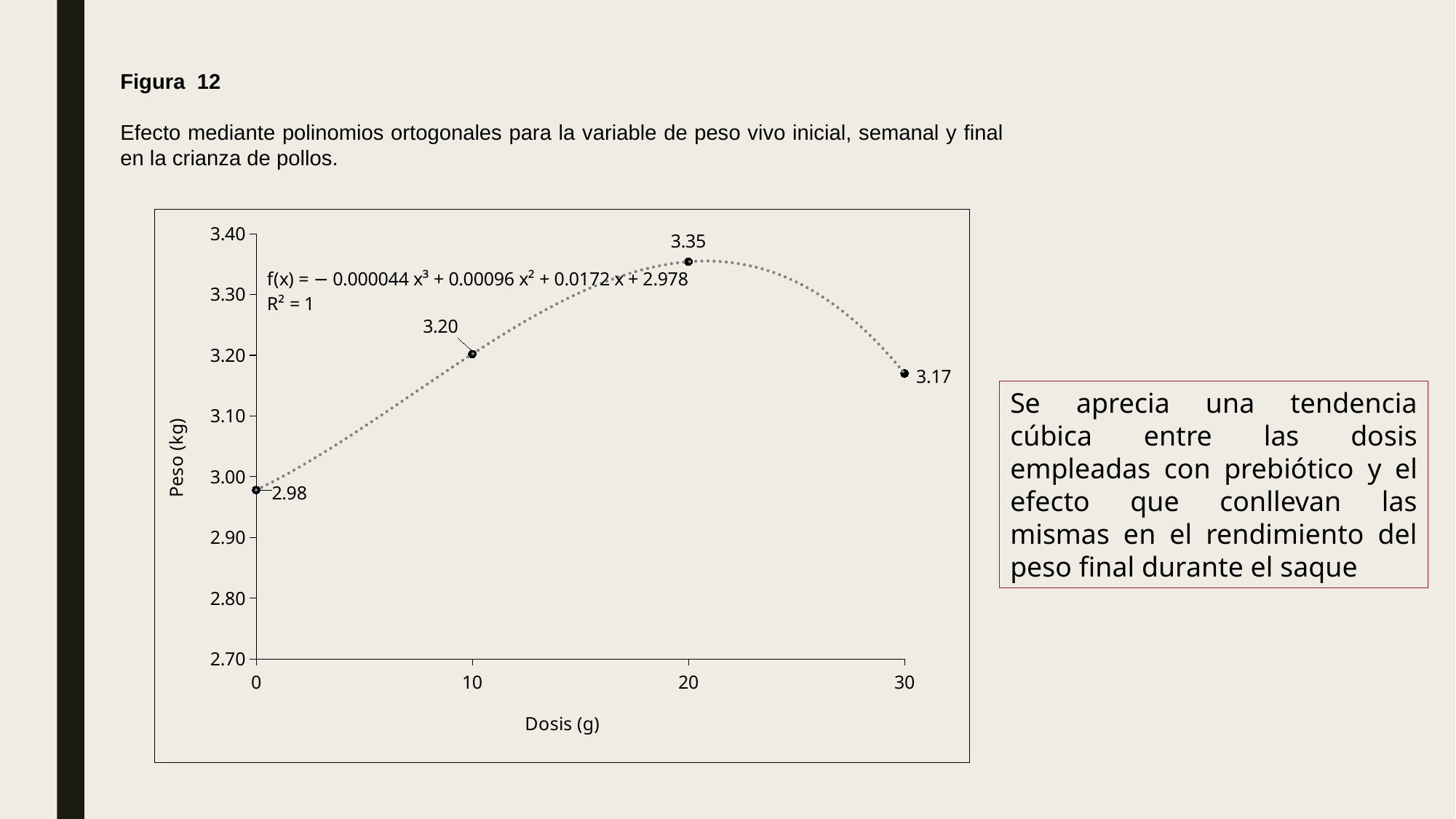
At which dose is the weight highest? 20 What is the weight (Peso) at a dose of 20 g? 3.35 What is the weight (Peso) at a dose of 0 g? 2.98 Which dose has a larger weight, 10 g or 30 g? 10 g What is the difference in weight between the 20 g dose and the 0 g dose? 0.37 At which dose is the weight lowest? 0 What is the weight (Peso) at a dose of 30 g? 3.17 What kind of chart is shown? Scatter chart with a trend line Does the weight rise or fall between doses of 20 g and 30 g? Fall How many data points are plotted on the chart? 4 What is the R² value shown on the chart? 1 What is the weight (Peso) at a dose of 10 g? 3.20